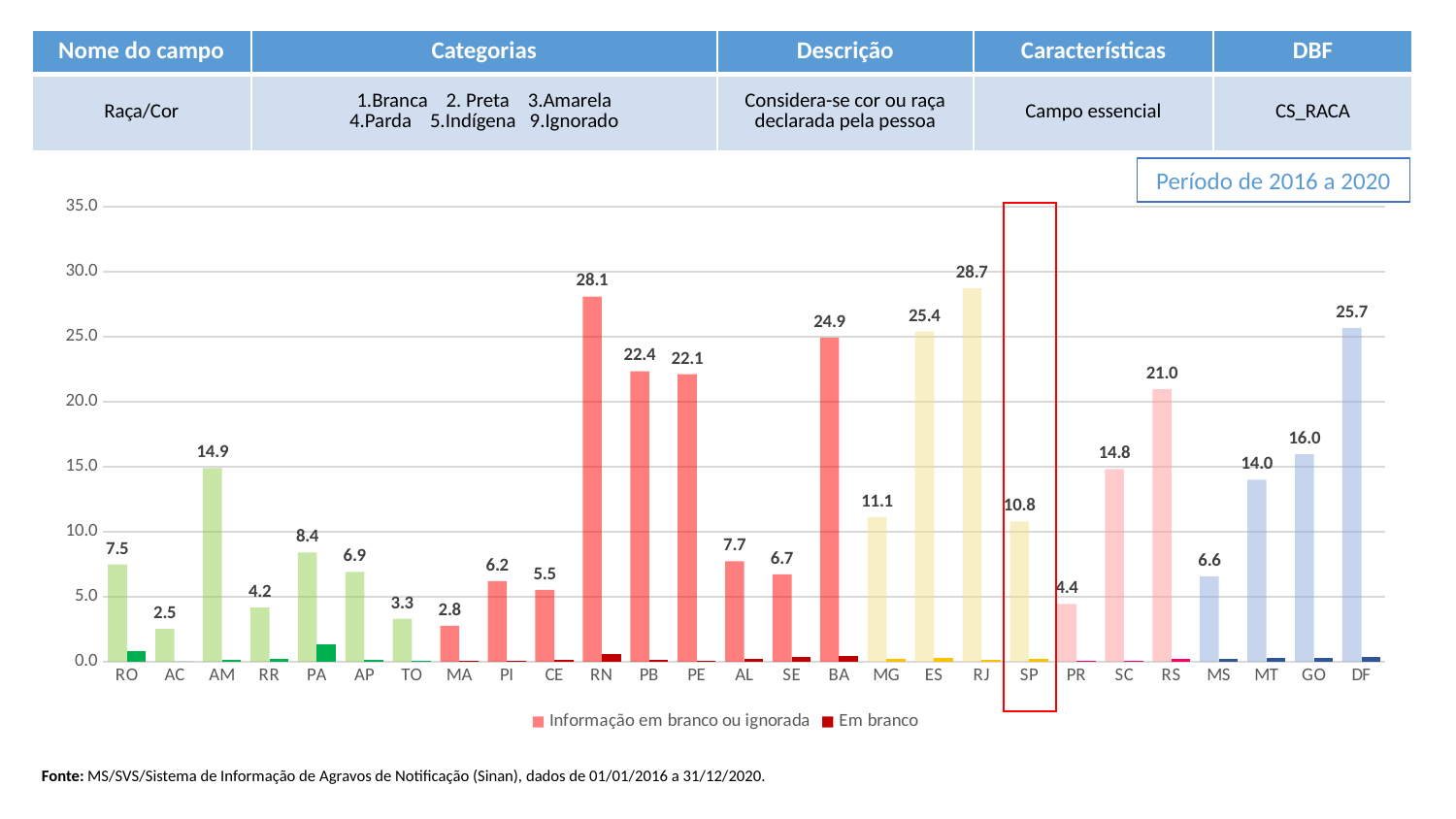
What is the value for RN for the series 'Informação em branco ou ignorada'? 28.1 What is the value for DF for the series 'Informação em branco ou ignorada'? 25.7 How many states are shown on the x axis of the chart? 27 What is the difference between the 'Informação em branco ou ignorada' values for RJ and SP? 17.9 Which state has the highest value for 'Informação em branco ou ignorada'? RJ What period does the chart cover, according to the label above it? Período de 2016 a 2020 Which state has the lowest value for 'Informação em branco ou ignorada'? AC Is the 'Informação em branco ou ignorada' value for RS greater or less than 20.0? greater How many series does the chart legend list? 2 What is the value for SP for the series 'Informação em branco ou ignorada'? 10.8 What kind of chart is shown on the slide? Bar chart Which has a larger 'Informação em branco ou ignorada' value, BA or ES? ES